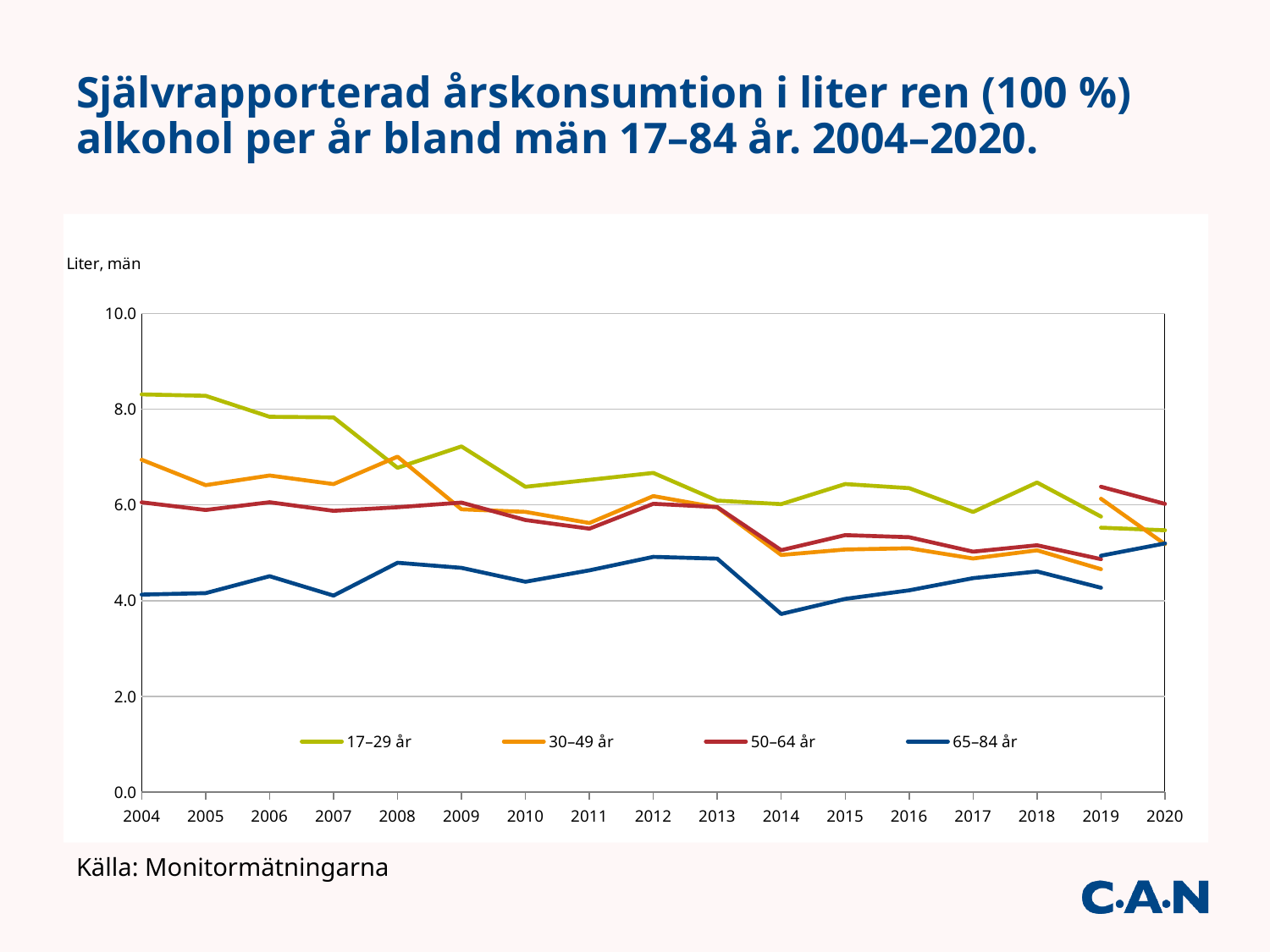
Which age group has the lowest value in 2004? 65–84 år How many series does the legend list? 4 Is the value for 50–64 år in 2014 greater or less than 6.0? less Does the value for 17–29 år rise or fall overall from 2004 to 2020? fall Is the value for 65–84 år in 2014 greater or less than 4.0? less How many years are shown on the x axis? 17 What kind of chart is shown on the slide? Line chart Is the value for 17–29 år in 2004 greater or less than 8.0? greater What is the label on the y axis of the chart? Liter, män Which age group has the highest value in 2004? 17–29 år Which age group has the lowest value in 2014? 65–84 år